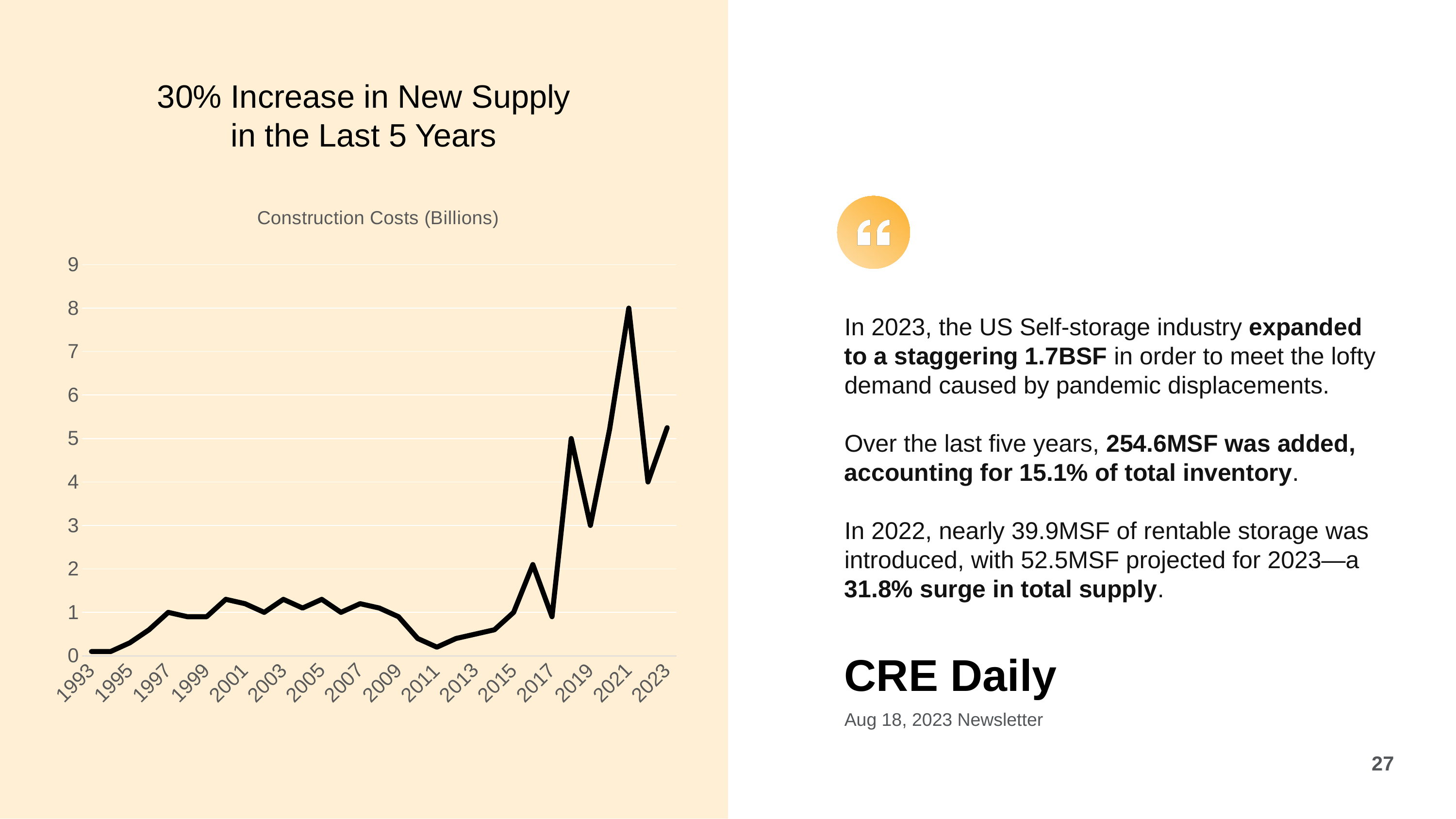
Is the value for 2021 greater or less than 7? greater In which year does the line reach its highest value? 2021 Is the value for 2023 greater or less than 4? greater Is the value for 2011 greater or less than 1? less What is the title of the chart? Construction Costs (Billions) Which year has the larger value, 2021 or 2023? 2021 What kind of chart is shown on the slide? line chart What is the first year labeled on the x axis? 1993 Does the line rise or fall between 2009 and 2011? fall Which year has the larger value, 2019 or 2020? 2020